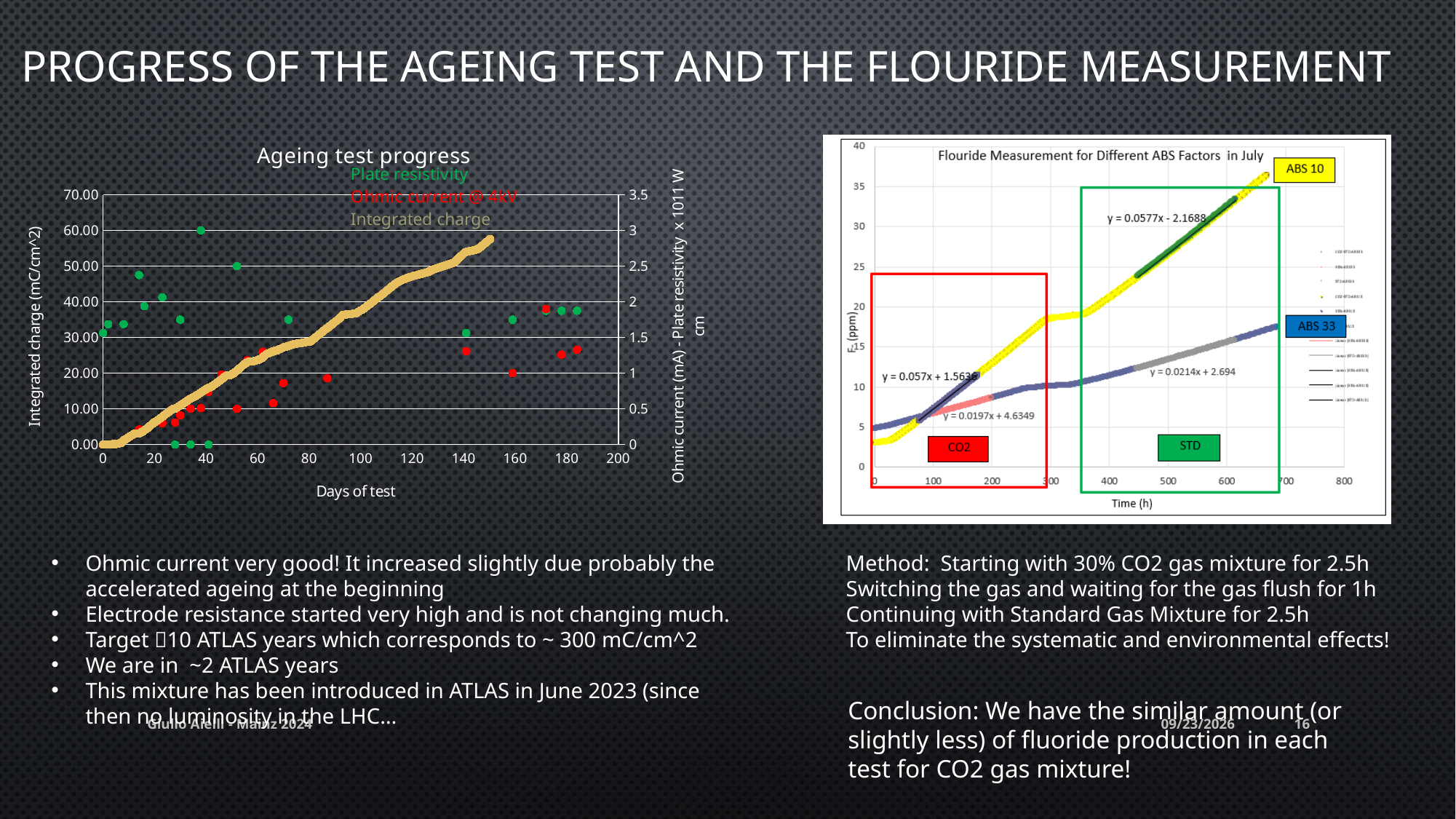
In the Ageing test progress chart, is the Integrated charge at day 60 greater or less than 40.00 mC/cm^2? less What is the title of the chart on the left of the slide? Ageing test progress In the Ageing test progress chart, does the Integrated charge rise or fall as the days of test increase? Rise In the Ageing test progress chart, is the Integrated charge at day 140 greater or less than 50.00 mC/cm^2? greater What is the title of the chart on the right of the slide? Flouride Measurement for Different ABS Factors in July In the Flouride Measurement chart, what is the fit equation shown for ABS 10 in the STD region? y = 0.0577x - 2.1688 In the Flouride Measurement chart, what is the fit equation shown for ABS 33 in the STD region? y = 0.0214x + 2.694 In the Flouride Measurement chart, is the fluoride value for ABS 33 at 600 h greater or less than 20 ppm? less In the Ageing test progress chart, how many series does the legend list? 3 What kind of chart is the Ageing test progress chart? Scatter chart In the Flouride Measurement chart, which ABS factor reaches the higher fluoride concentration, ABS 10 or ABS 33? ABS 10